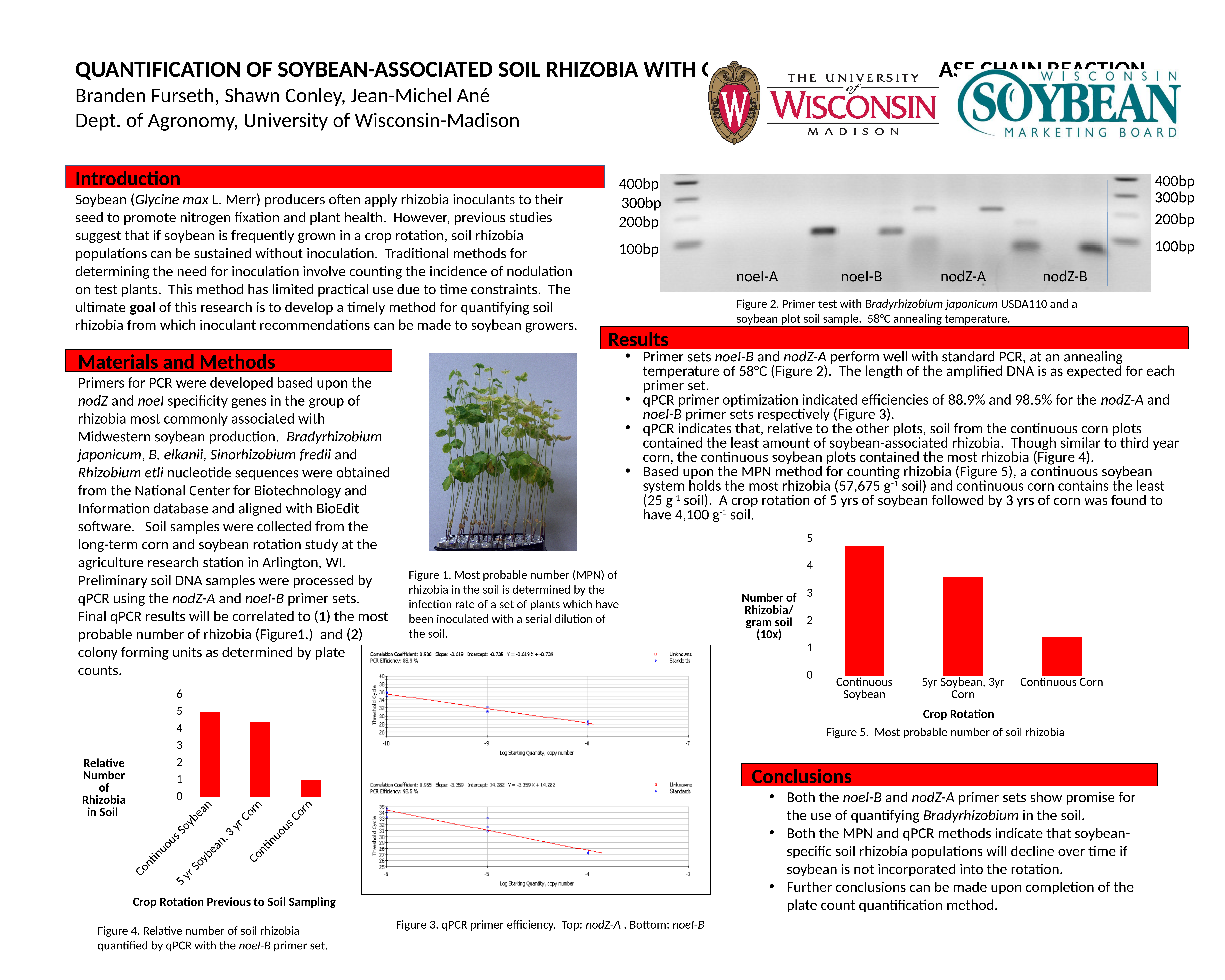
In Figure 5 (right chart), which crop rotation has the lowest number of rhizobia per gram soil? Continuous Corn What is the x-axis title of Figure 5 (right chart)? Crop Rotation In Figure 5 (right chart), is the value for Continuous Corn greater or less than 2? less In Figure 4 (bottom-left chart), which crop rotation has the lowest relative number of rhizobia in soil? Continuous Corn In Figure 4 (bottom-left chart), is the value for Continuous Corn greater or less than 2? less In Figure 5 (right chart), which is larger: the value for 5yr Soybean, 3yr Corn or the value for Continuous Corn? 5yr Soybean, 3yr Corn In Figure 5 (right chart), is the value for Continuous Soybean greater or less than 4? greater In Figure 4 (bottom-left chart), how many crop rotation categories are shown? 3 What kind of chart is Figure 4 (bottom-left chart)? bar chart In Figure 4 (bottom-left chart), which crop rotation has the highest relative number of rhizobia in soil? Continuous Soybean In Figure 5 (right chart), which crop rotation has the highest number of rhizobia per gram soil? Continuous Soybean